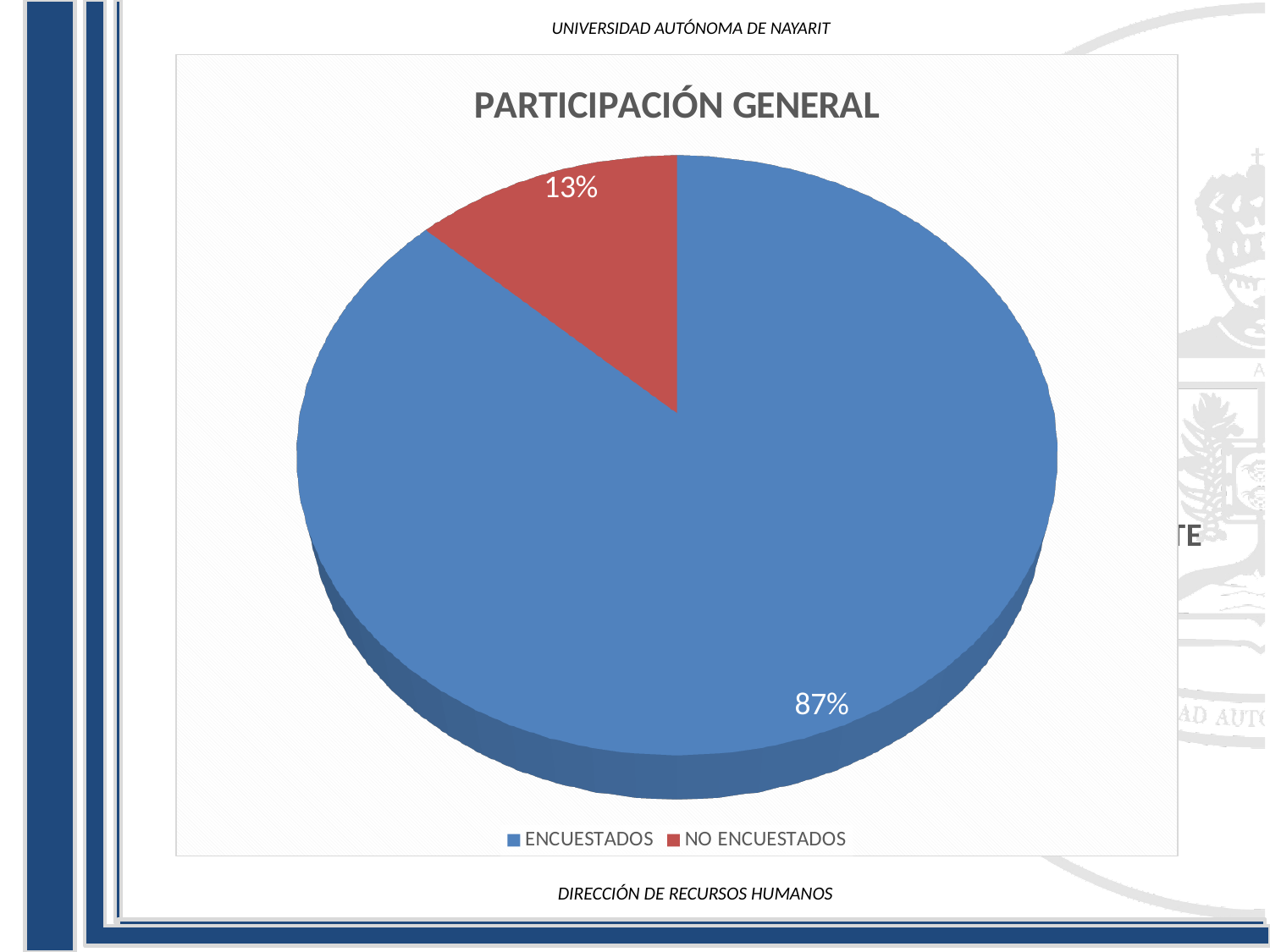
What is the difference in percentage points between ENCUESTADOS and NO ENCUESTADOS? 74 How many categories does the pie chart show? 2 What percentage of the pie is NO ENCUESTADOS? 13% What percentage of the pie is ENCUESTADOS? 87% What kind of chart is shown on the slide? pie chart Which category has the smallest share of the pie? NO ENCUESTADOS What is the share of the pie for ENCUESTADOS? 87% What colour is the NO ENCUESTADOS slice? red Which category has the largest share of the pie? ENCUESTADOS How many entries does the legend list? 2 Which is larger, the share for ENCUESTADOS or the share for NO ENCUESTADOS? ENCUESTADOS What is the title of the chart? PARTICIPACIÓN GENERAL